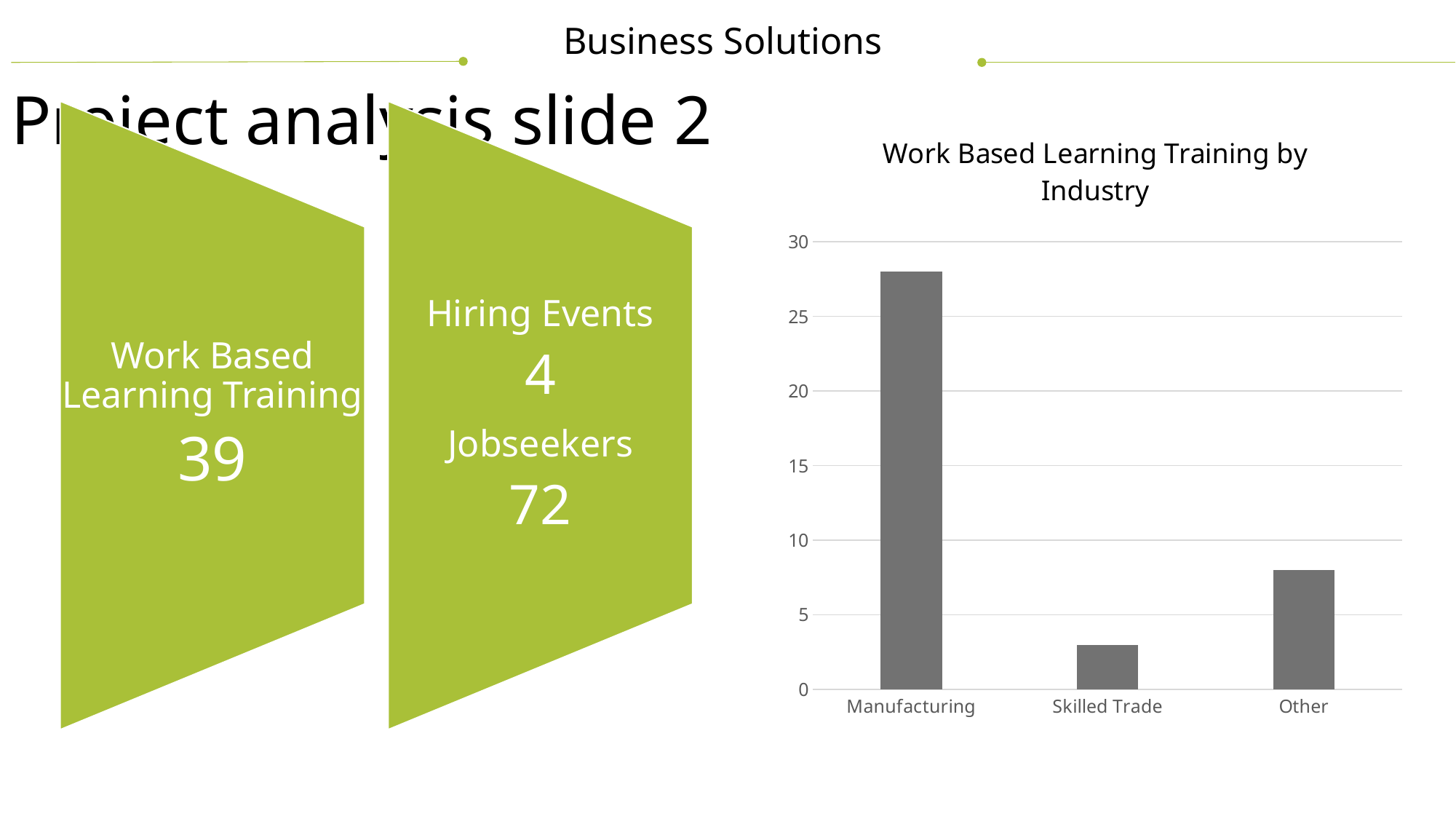
Is the value for Manufacturing greater or less than 25? greater Which has a larger value, Manufacturing or Other? Manufacturing Is the value for Other greater or less than 10? less Which industry has the highest value in the chart? Manufacturing How many categories are shown on the x axis of the chart? 3 Is the value for Other greater or less than 5? greater What is the highest value shown on the chart's vertical axis? 30 Which has a larger value, Other or Skilled Trade? Other Which industry has the lowest value in the chart? Skilled Trade What type of chart is shown on the slide? bar chart What is the title of the chart? Work Based Learning Training by Industry